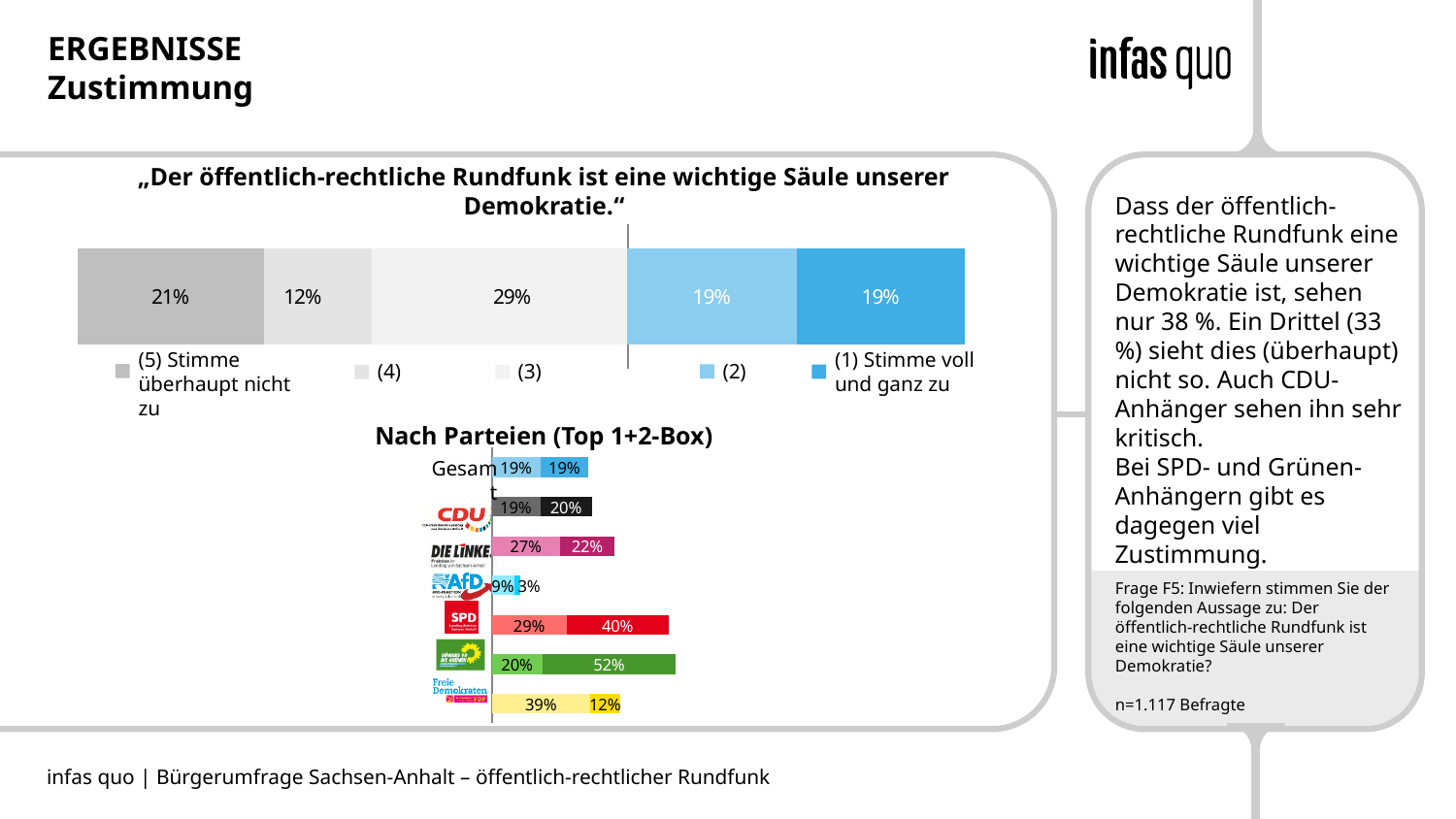
In the chart "Nach Parteien (Top 1+2-Box)", what is the second (darker) value shown for SPD? 40% In the top chart, what percentage is shown for category "(3)"? 29% In the chart "Nach Parteien (Top 1+2-Box)", what is the first value shown for FDP? 39% In the chart "Nach Parteien (Top 1+2-Box)", how many bars (rows) are shown? 7 In the chart "Nach Parteien (Top 1+2-Box)", which party has the shortest bar? AfD In the top chart, which category has the smallest share? (4) In the chart "Nach Parteien (Top 1+2-Box)", what is the total of the two values for the Grünen bar? 72% In the top chart "Der öffentlich-rechtliche Rundfunk ist eine wichtige Säule unserer Demokratie", what percentage is shown for "(5) Stimme überhaupt nicht zu"? 21% What kind of chart is the top chart? Stacked bar chart In the top chart, how many categories does the legend list? 5 In the top chart, which category has the largest share? (3) In the top chart, what is the difference between the share for "(3)" and the share for "(4)"? 17%